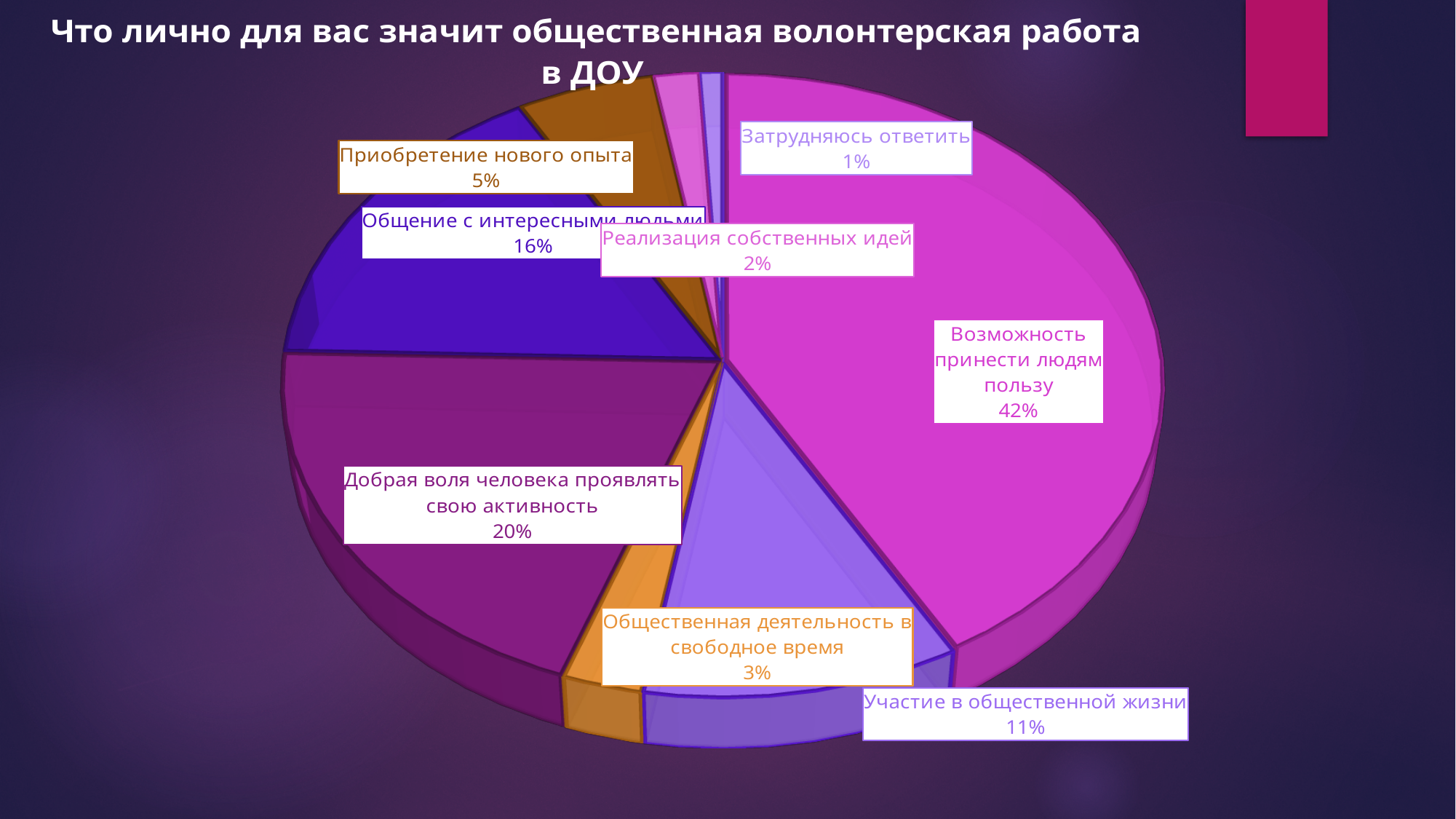
What is the value for "Участие в общественной жизни"? 11% What is the value for "Затрудняюсь ответить"? 1% What is the value for "Добрая воля человека проявлять свою активность"? 20% Which category has the largest slice of the pie? Возможность принести людям пользу What is the difference between the values for "Возможность принести людям пользу" and "Добрая воля человека проявлять свою активность"? 22% What is the title of the chart on the slide? Что лично для вас значит общественная волонтерская работа в ДОУ How many categories (slices) does the pie chart have? 8 What is the value for "Общение с интересными людьми"? 16% Which is larger: "Приобретение нового опыта" or "Общественная деятельность в свободное время"? Приобретение нового опыта What kind of chart is shown on the slide? Pie chart What share of the pie does "Возможность принести людям пользу" have? 42% Which category has the smallest slice of the pie? Затрудняюсь ответить